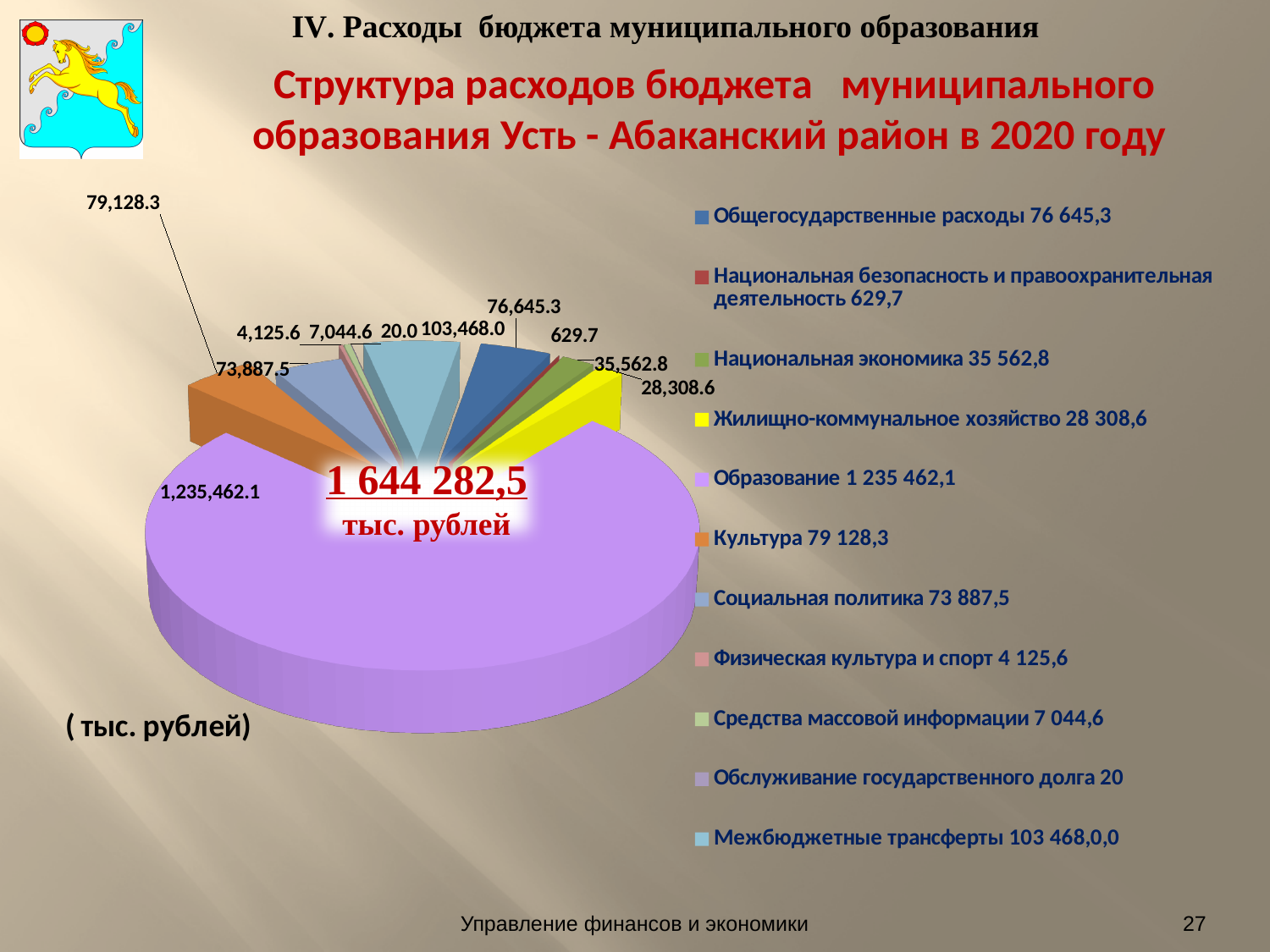
Which is larger: Общегосударственные расходы or Социальная политика? Общегосударственные расходы What type of chart is shown on the slide? Pie chart What total value is printed in the centre of the pie chart? 1 644 282,5 тыс. рублей What is the difference between the values for Культура and Социальная политика? 5,240.8 What is the value shown for Межбюджетные трансферты? 103,468.0 Which category has the largest share of the pie? Образование What is the difference between the values for Национальная экономика and Жилищно-коммунальное хозяйство? 7,254.2 In what units are the values of the chart given? тыс. рублей What is the value shown for Культура? 79,128.3 What is the value shown for Образование? 1,235,462.1 How many expenditure categories does the pie chart show? 11 Which category has the smallest value in the chart? Обслуживание государственного долга